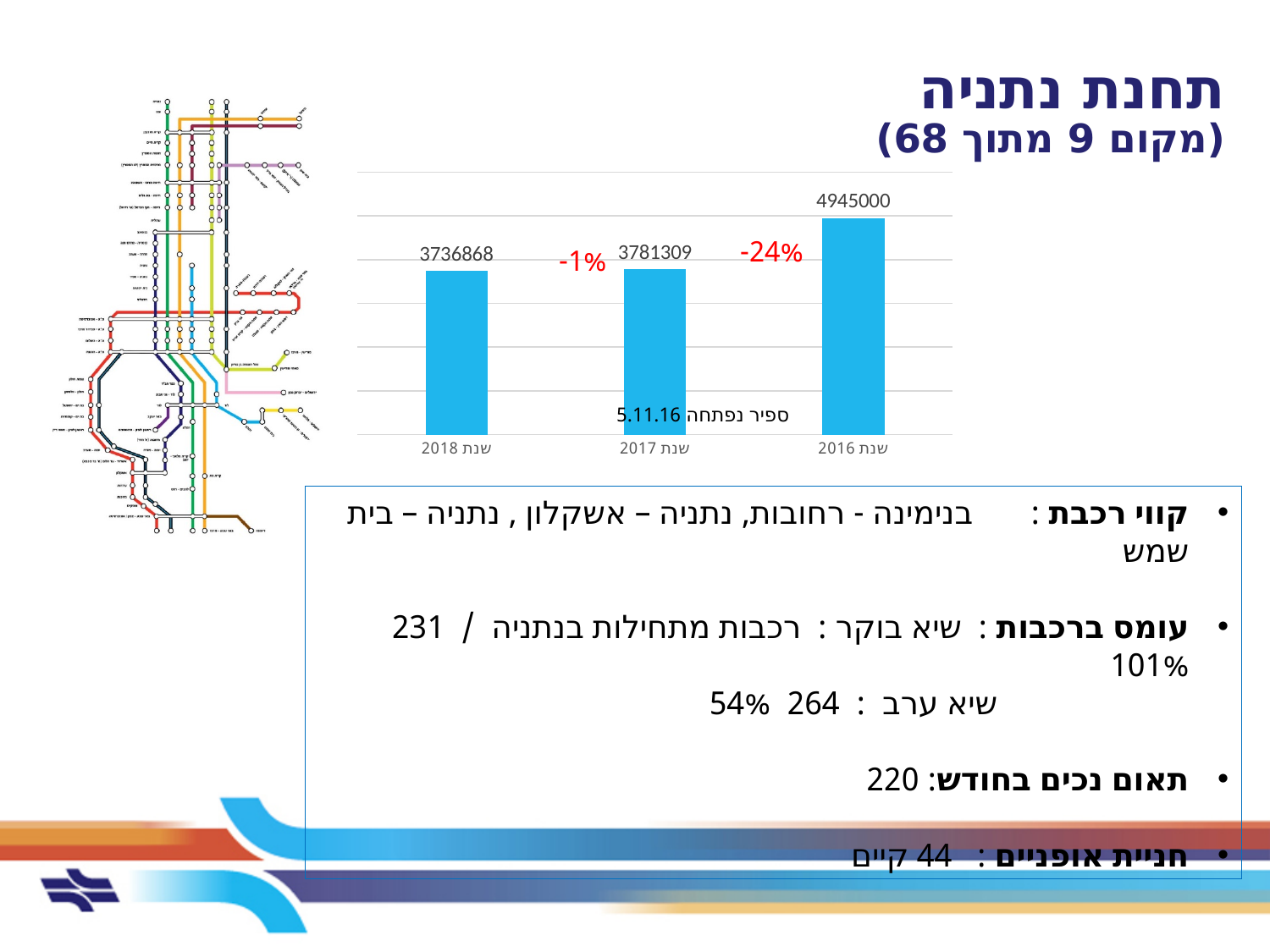
What percentage change is annotated in red between שנת 2016 and שנת 2017? -24% What is the value shown for שנת 2018? 3736868 Do the values rise or fall from שנת 2016 to שנת 2018? fall What is the value shown for שנת 2016? 4945000 Which year has the highest value in the chart? שנת 2016 What is the difference between the values for שנת 2017 and שנת 2018? 44441 What is the value shown for שנת 2017? 3781309 What is the difference between the values for שנת 2016 and שנת 2017? 1163691 Which year has the lowest value in the chart? שנת 2018 What kind of chart is shown on the slide? bar chart Which is larger, the value for שנת 2016 or the value for שנת 2018? שנת 2016 How many bars are plotted in the chart? 3